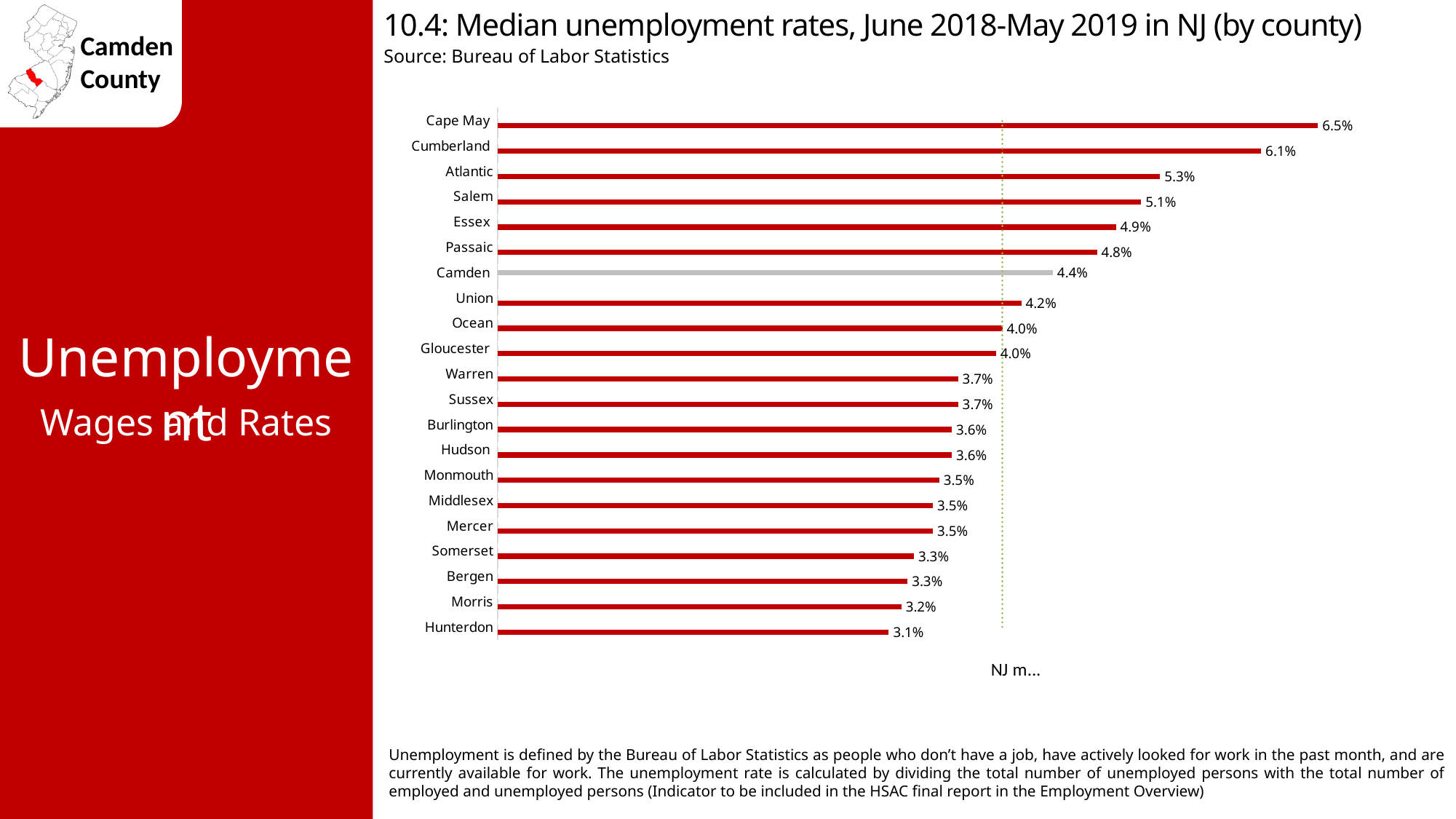
Which county has a higher median unemployment rate, Morris or Salem? Salem What kind of chart is used to show the median unemployment rates? Bar chart Which county has the highest median unemployment rate? Cape May What is the median unemployment rate for Camden County? 4.4% Which county's bar is shown in grey rather than red? Camden What is the median unemployment rate for Cumberland County? 6.1% Which county has the lowest median unemployment rate? Hunterdon Which county has a higher median unemployment rate, Essex or Union? Essex What is the difference between the median unemployment rates of Cape May and Hunterdon? 3.4% How many counties are shown in the chart? 21 What is the difference between the median unemployment rates of Camden and Atlantic? 0.9% What is the median unemployment rate for Hunterdon County? 3.1%